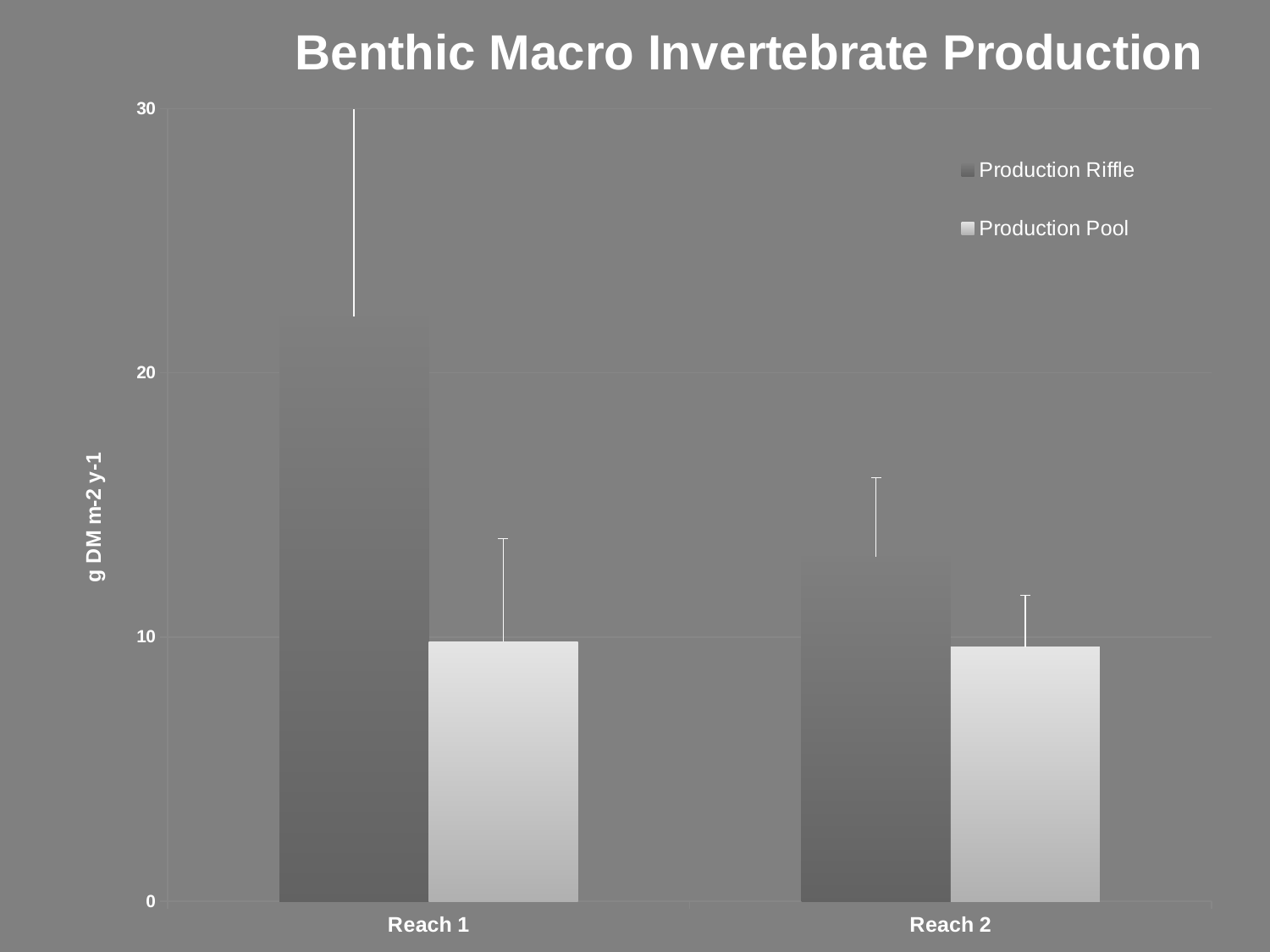
Which is larger, the Production Riffle value for Reach 1 or for Reach 2? Reach 1 Which is larger for Reach 1, Production Riffle or Production Pool? Production Riffle What kind of chart is shown on the slide? bar chart Is the Production Riffle value for Reach 1 greater or less than 30? less Is the Production Riffle value for Reach 1 greater or less than 20? greater How many series does the legend list? 2 Which bar is the highest in the chart? Production Riffle for Reach 1 Is the Production Riffle value for Reach 2 greater or less than 10? greater What are the two series named in the legend? Production Riffle and Production Pool How many categories are shown on the x axis? 2 What is the title of the chart? Benthic Macro Invertebrate Production